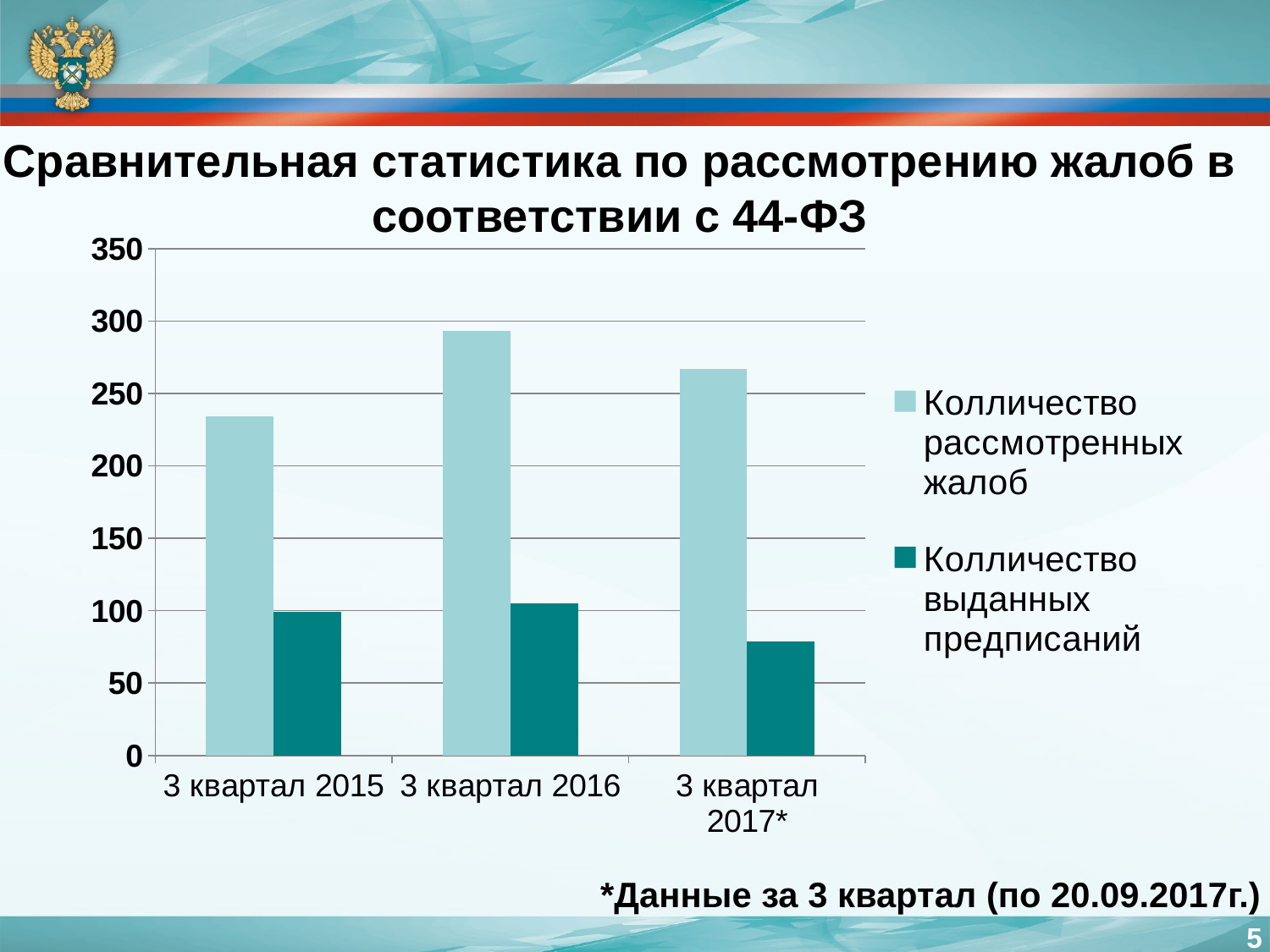
How many categories are shown on the x axis? 3 Does the value for 'Колличество рассмотренных жалоб' rise or fall from 3 квартал 2016 to 3 квартал 2017*? fall Is the value for 'Колличество рассмотренных жалоб' in 3 квартал 2017* greater or less than 250? greater Which quarter has the lowest value for 'Колличество рассмотренных жалоб'? 3 квартал 2015 How many series does the legend list? 2 What kind of chart is shown on the slide? Bar chart Is the value for 'Колличество выданных предписаний' in 3 квартал 2017* greater or less than 100? less Which quarter has the lowest value for 'Колличество выданных предписаний'? 3 квартал 2017* Which is larger: 'Колличество рассмотренных жалоб' in 3 квартал 2017* or in 3 квартал 2015? 3 квартал 2017* Is the value for 'Колличество рассмотренных жалоб' in 3 квартал 2015 greater or less than 250? less What is the title of the chart? Сравнительная статистика по рассмотрению жалоб в соответствии с 44-ФЗ Which quarter has the highest value for 'Колличество рассмотренных жалоб'? 3 квартал 2016